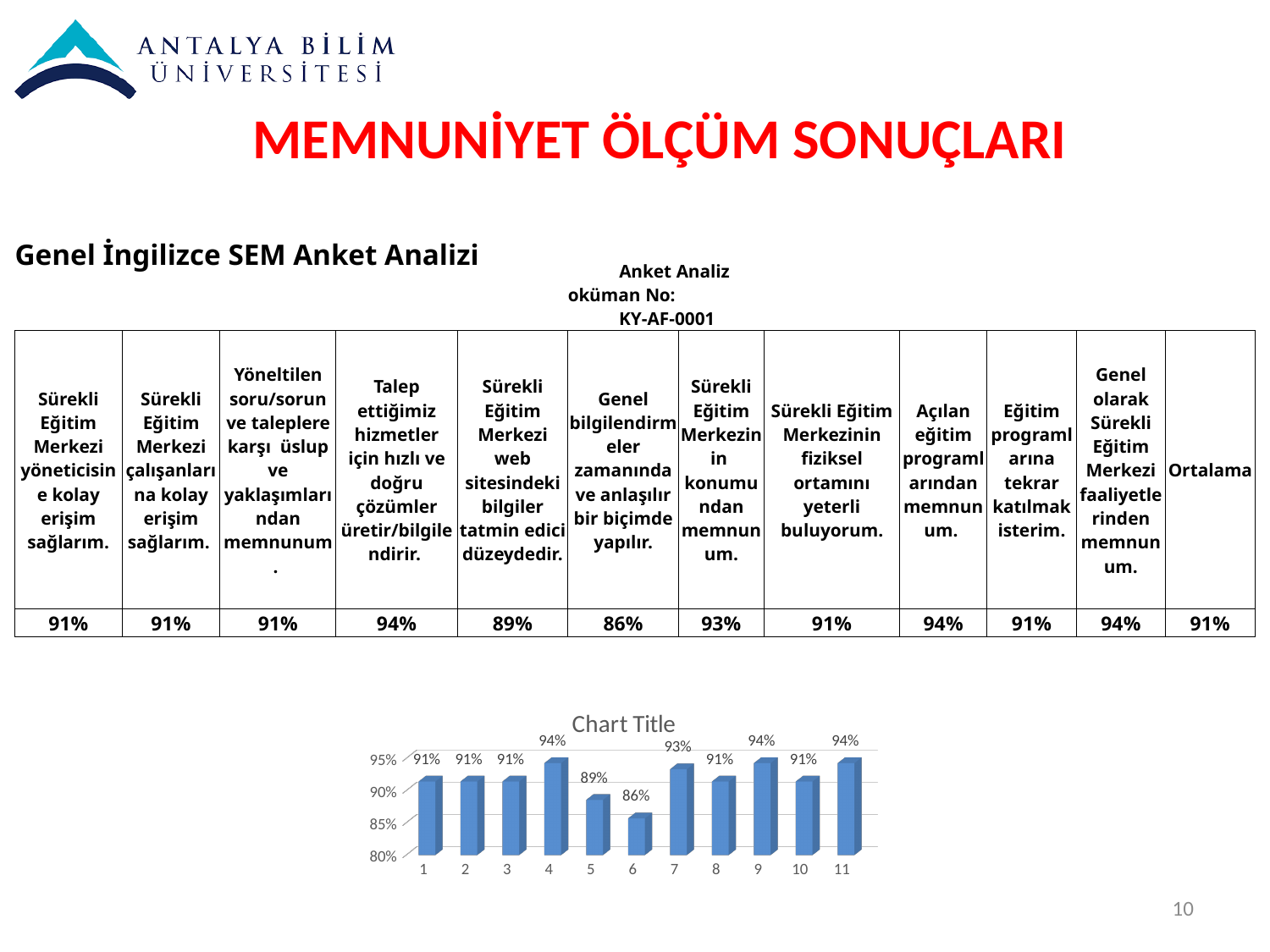
What is the title of the chart? Chart Title What is the value of bar 6 in the chart? 86% What is the difference between the values of bar 7 and bar 5? 4% Is the value for bar 9 greater or less than 90%? greater What is the value of bar 7 in the chart? 93% Is the value for bar 6 greater or less than 90%? less How many bars are plotted in the chart? 11 What is the value of bar 5 in the chart? 89% What type of chart is shown on the slide? bar chart Which category has the lowest value in the chart? 6 Which is larger, the value of bar 5 or the value of bar 8? bar 8 What is the difference between the values of bar 4 and bar 6? 8%